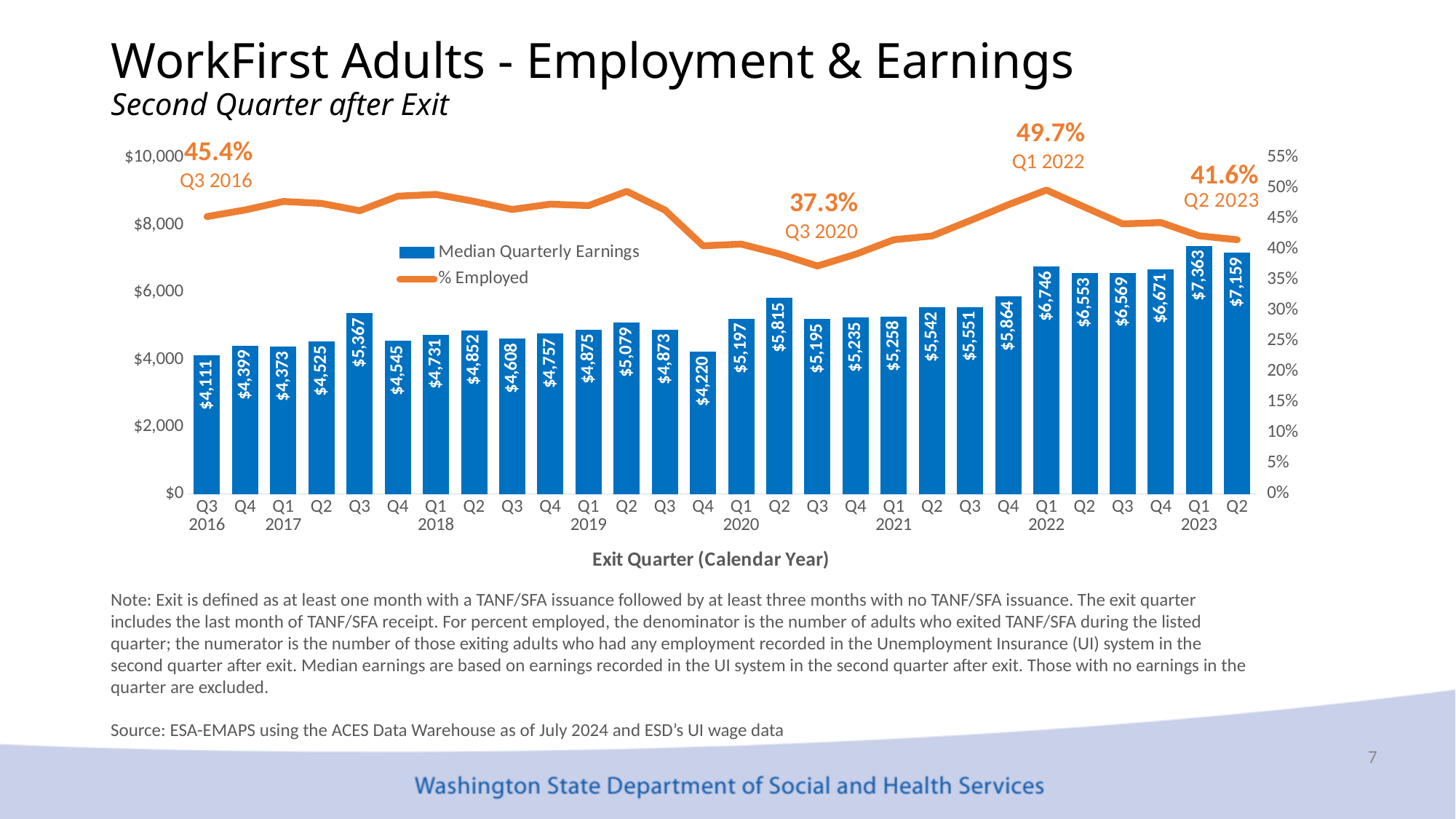
Which exit quarter has the lowest median quarterly earnings? Q3 2016 What percent employed is labeled for Q1 2022? 49.7% What is the difference in median quarterly earnings between Q1 2023 and Q2 2023? $204 Which has higher median quarterly earnings, Q2 2022 or Q3 2022? Q3 2022 Which exit quarter has the highest median quarterly earnings? Q1 2023 How many exit quarters are shown on the x axis? 28 What is the median quarterly earnings value for Q1 2023? $7,363 What is the median quarterly earnings value for Q4 2019? $4,220 Is the % Employed value for Q1 2018 greater or less than 45%? greater How many series does the legend list? 2 What kind of chart is shown on the slide? Combination bar and line chart What percent employed is labeled for Q3 2020? 37.3%